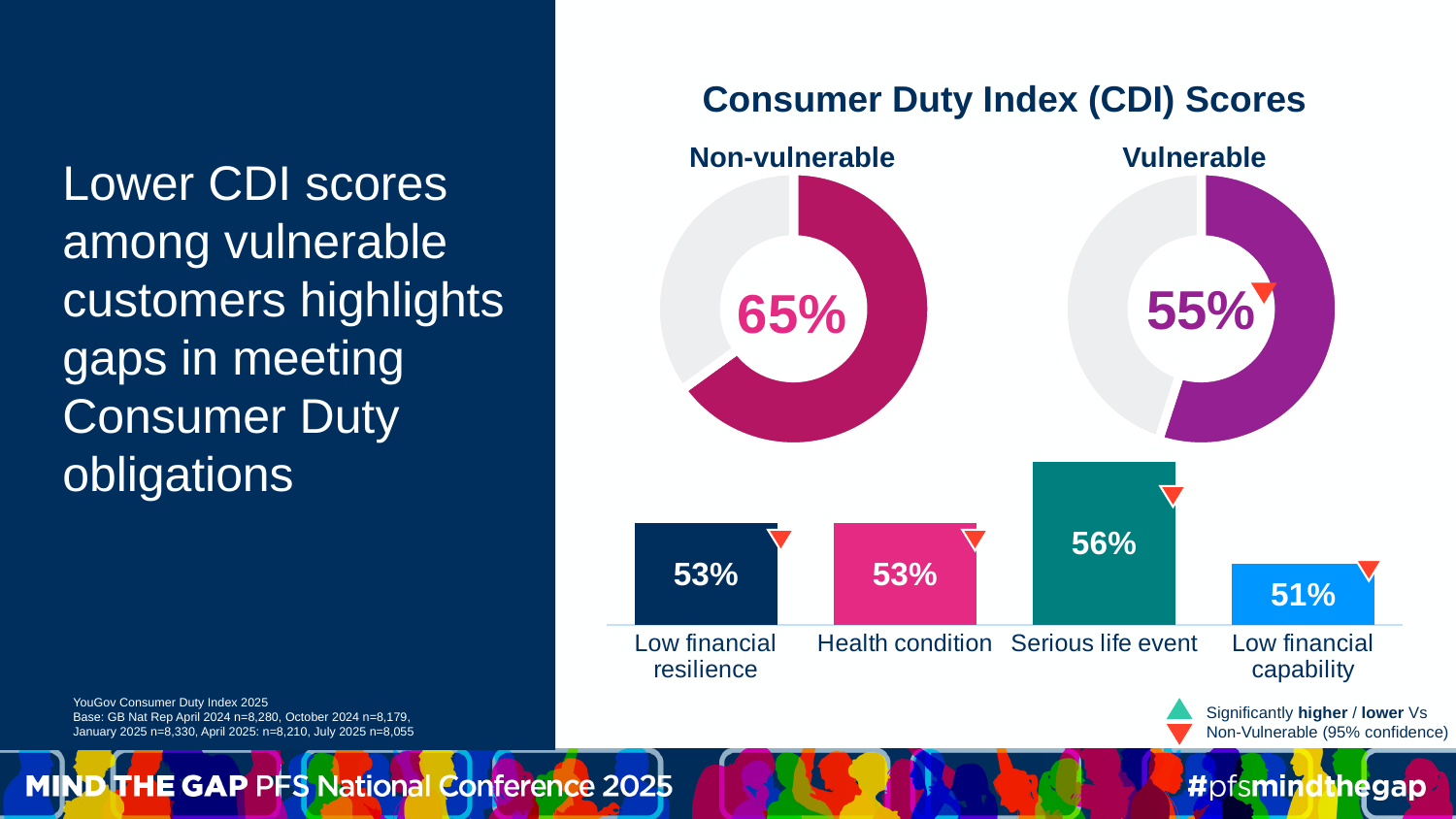
In the bar chart at the bottom of the slide, which category has the highest value? Serious life event In the Vulnerable donut chart, what CDI score is shown? 55% Which of the two donut charts shows the larger CDI score, Non-vulnerable or Vulnerable? Non-vulnerable In the bar chart at the bottom of the slide, what is the value for Low financial capability? 51% In the bar chart at the bottom of the slide, what is the value for Health condition? 53% How many categories are shown in the bar chart at the bottom of the slide? 4 What type of chart is used to show the Non-vulnerable and Vulnerable CDI scores? Donut chart In the bar chart at the bottom of the slide, what is the value for Serious life event? 56% In the bar chart at the bottom of the slide, what is the difference between Serious life event and Low financial capability? 5 percentage points In the bar chart at the bottom of the slide, which category has the lowest value? Low financial capability What is the difference between the Non-vulnerable and Vulnerable CDI scores shown in the two donut charts? 10 percentage points In the Non-vulnerable donut chart, what CDI score is shown? 65%